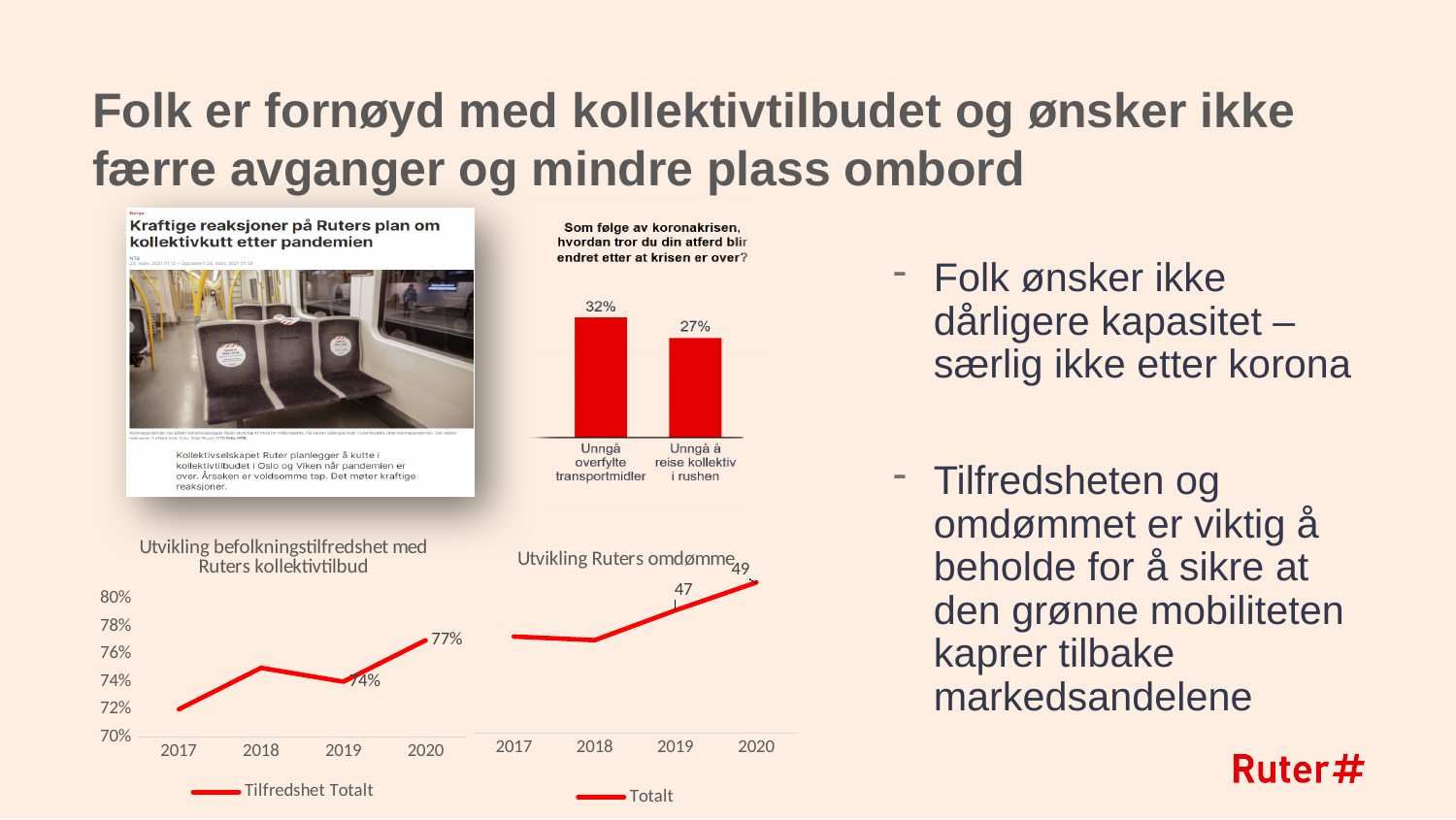
How many bars are shown in the bar chart at the top centre of the slide? 2 What kind of chart is "Utvikling befolkningstilfredshet med Ruters kollektivtilbud"? line chart In the chart "Utvikling Ruters omdømme", what is the value for 2020? 49 In the chart "Utvikling befolkningstilfredshet med Ruters kollektivtilbud", what is the value for 2019? 74% In the bar chart at the top centre of the slide, what is the difference between the two bars? 5% In the chart "Utvikling Ruters omdømme", what is the name of the series shown in the legend? Totalt In the chart "Utvikling befolkningstilfredshet med Ruters kollektivtilbud", what is the value for 2020? 77% In the bar chart at the top centre of the slide, which category has the highest value? Unngå overfylte transportmidler In the bar chart titled "Som følge av koronakrisen, hvordan tror du din atferd blir endret etter at krisen er over?", what is the value for "Unngå overfylte transportmidler"? 32% In the bar chart titled "Som følge av koronakrisen, hvordan tror du din atferd blir endret etter at krisen er over?", what is the value for "Unngå å reise kollektiv i rushen"? 27% In the chart "Utvikling befolkningstilfredshet med Ruters kollektivtilbud", is the value for 2017 greater or less than 74%? less In the chart "Utvikling Ruters omdømme", what is the difference between the 2020 and 2019 values? 2